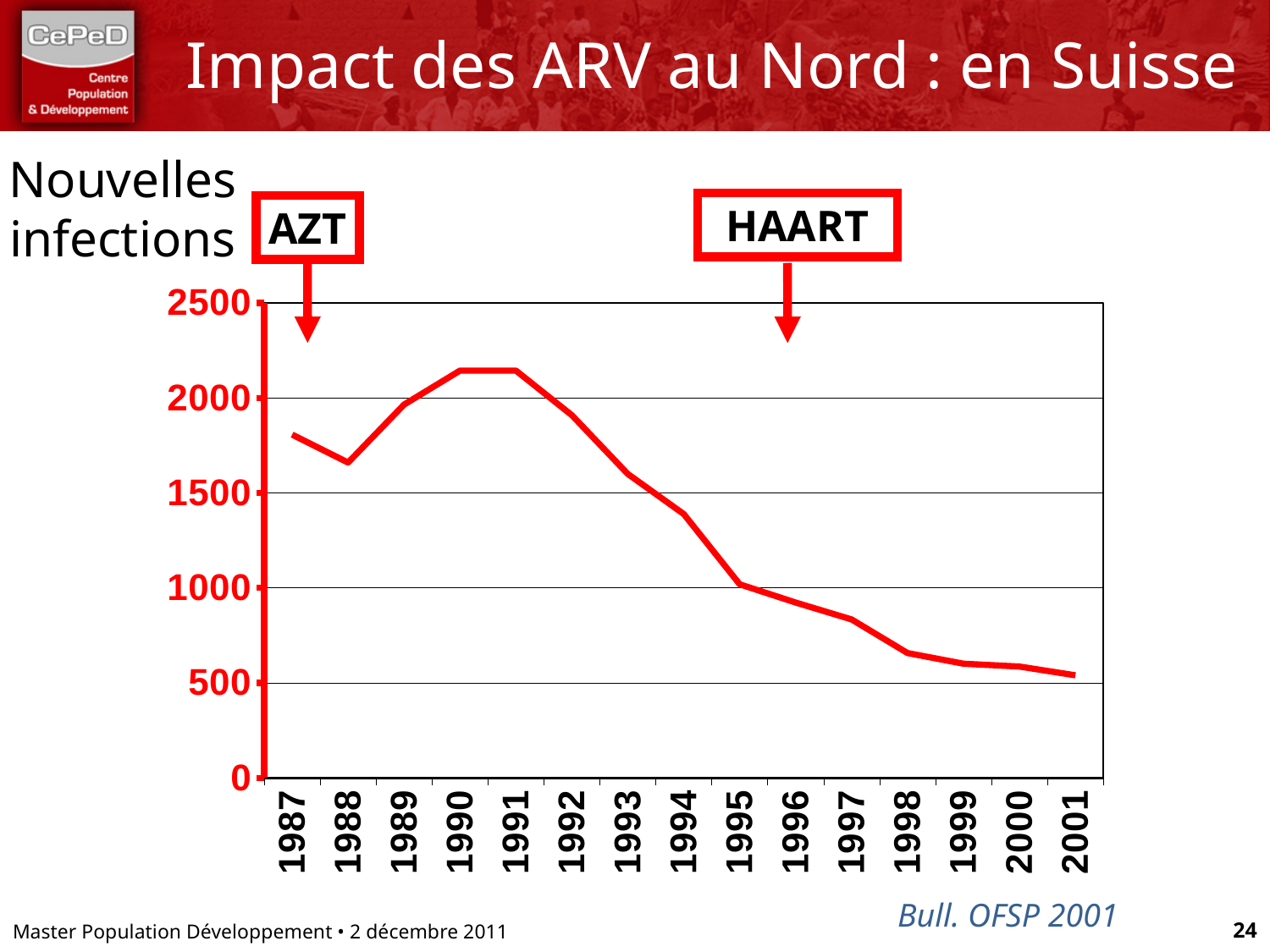
Is the value for 1990 greater or less than 2000? greater What two treatment labels are annotated with arrows above the chart? AZT and HAART Do the values rise or fall between 1991 and 2001? fall What is the title of the slide containing the chart? Impact des ARV au Nord : en Suisse Is the value for 2001 greater or less than 500? greater Which year has the larger value, 1990 or 1987? 1990 Is the value for 1994 greater or less than 1500? less How many years are plotted along the x axis of the chart? 15 What kind of chart is shown on the slide? line chart Which year has the larger value, 1994 or 1998? 1994